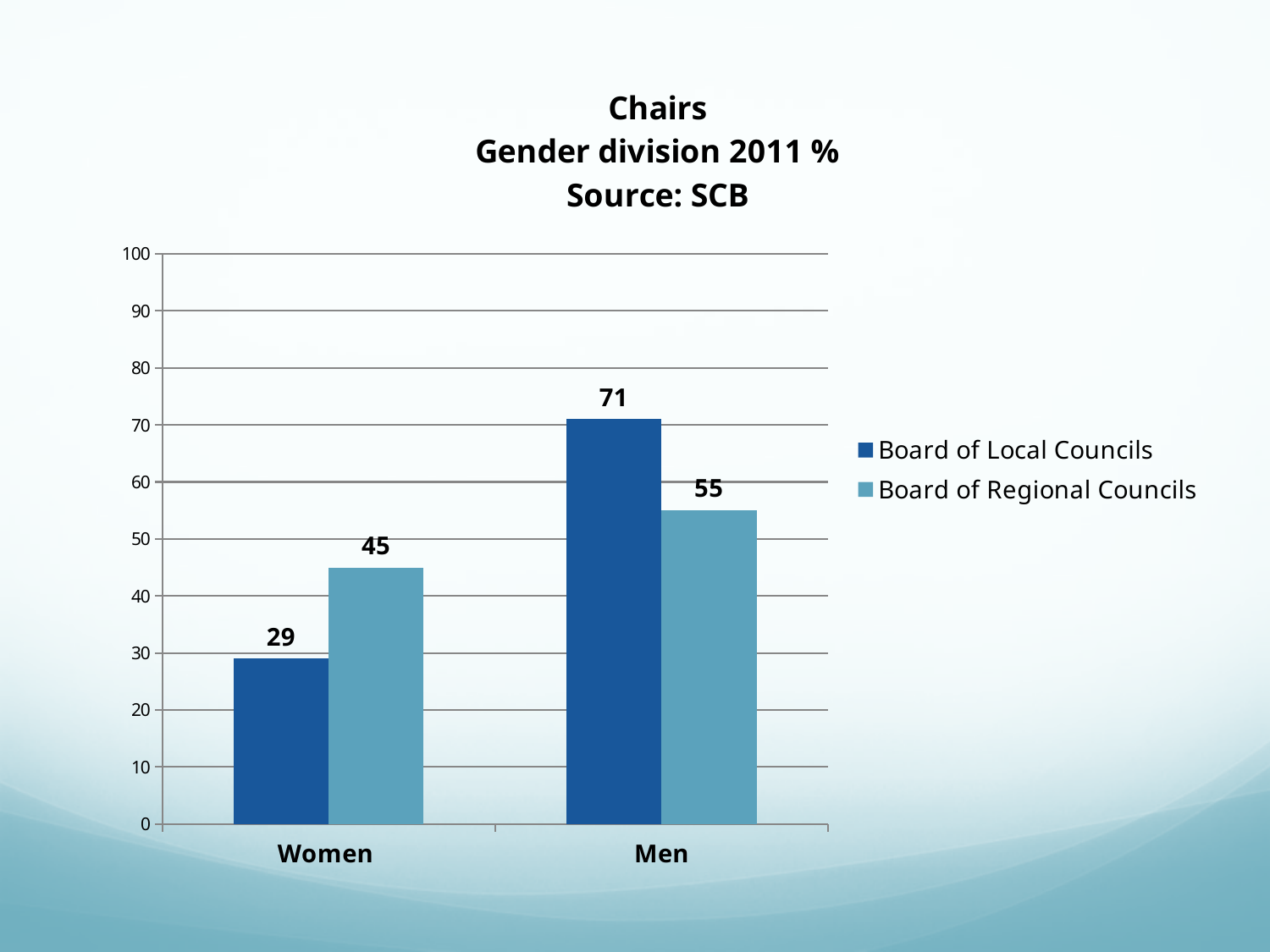
What is the value for Women in the Board of Regional Councils series? 45 How many categories are shown on the x axis? 2 What is the value for Women in the Board of Local Councils series? 29 Which is larger for Women: Board of Local Councils or Board of Regional Councils? Board of Regional Councils How many series does the legend list? 2 What is the difference between the Board of Local Councils and Board of Regional Councils values for Men? 16 What is the value for Men in the Board of Regional Councils series? 55 Is the value for Men in the Board of Local Councils series greater or less than 60? greater Which category has the highest value in the Board of Local Councils series? Men What kind of chart is shown on the slide? Bar chart Which category has the lowest value in the Board of Regional Councils series? Women What is the difference between the Board of Local Councils values for Men and Women? 42